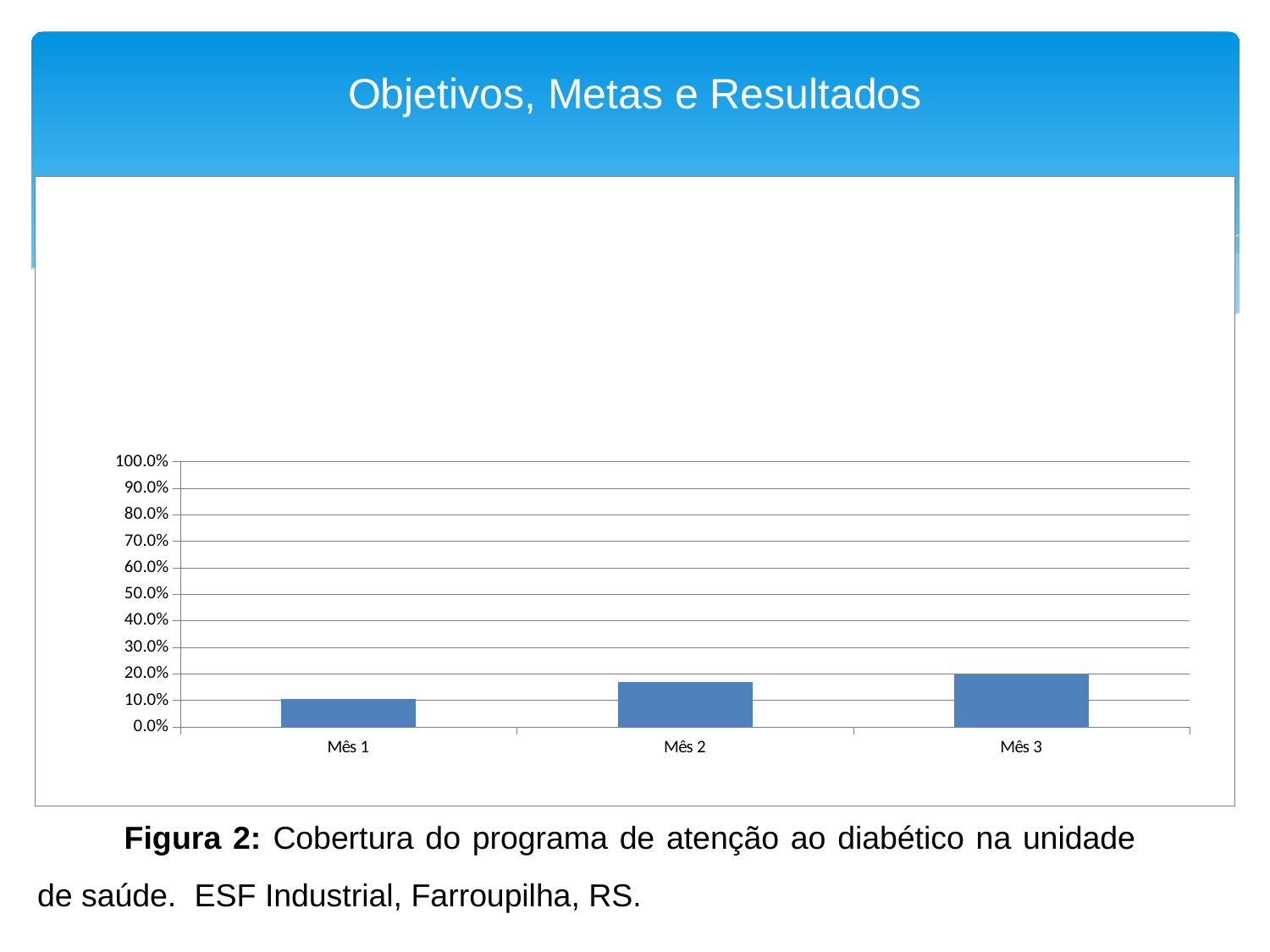
Is the value for Mês 3 greater or less than 10.0%? greater Is the value for Mês 3 greater or less than 30.0%? less Is the value for Mês 2 greater or less than 30.0%? less What kind of chart is shown on the slide? bar chart How many categories (months) are shown on the x axis of the chart? 3 What is the highest value shown on the y axis of the chart? 100.0% Which month has the highest bar in the chart? Mês 3 Do the values rise or fall from Mês 1 to Mês 3? rise Which month has the lowest bar in the chart? Mês 1 Which is larger, the value for Mês 1 or the value for Mês 2? Mês 2